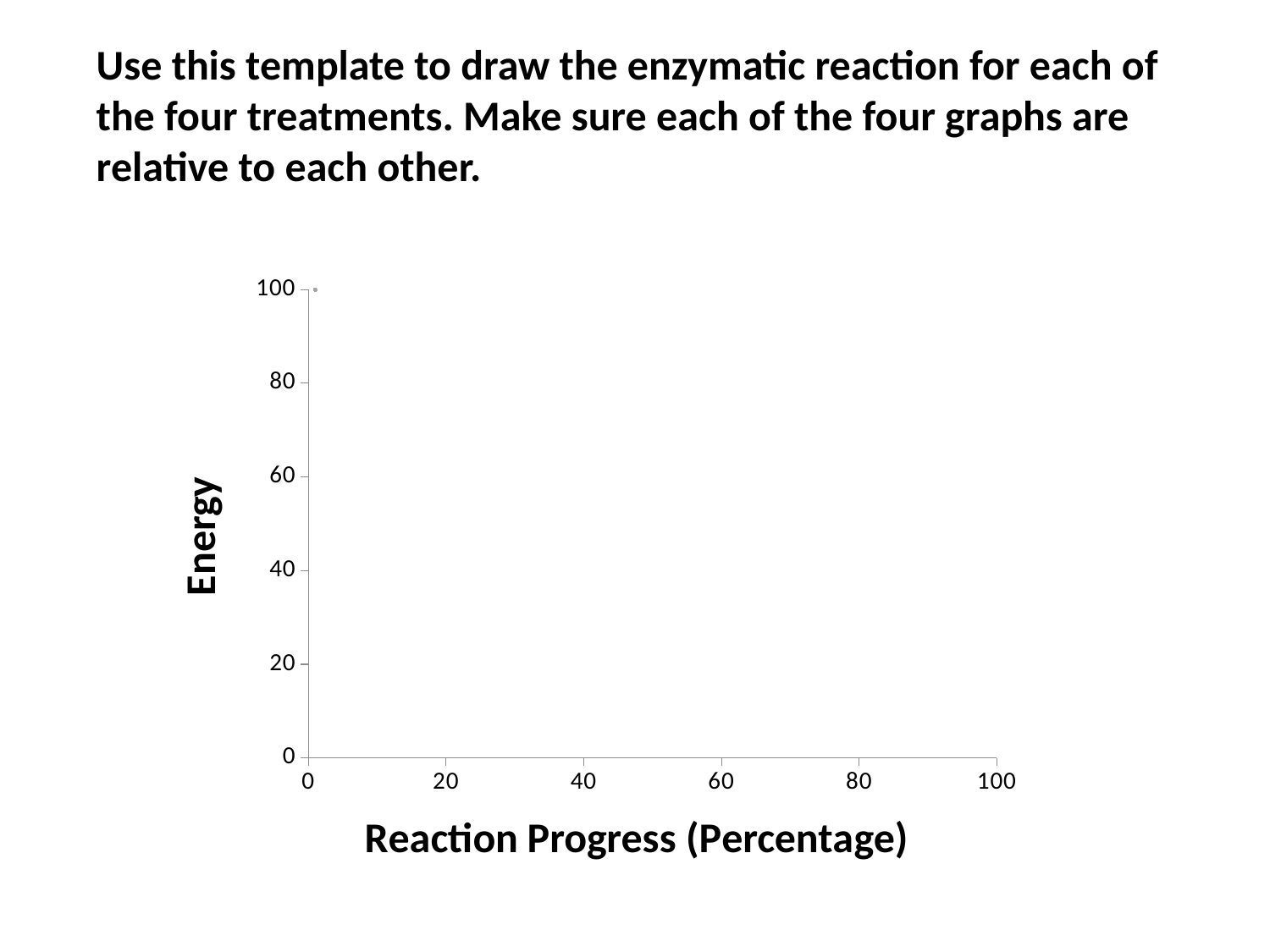
How many data points are plotted on the chart? 1 What is the title of the x axis on the chart? Reaction Progress (Percentage) What is the title of the y axis on the chart? Energy What is the Energy value of the single plotted point on the chart? 100